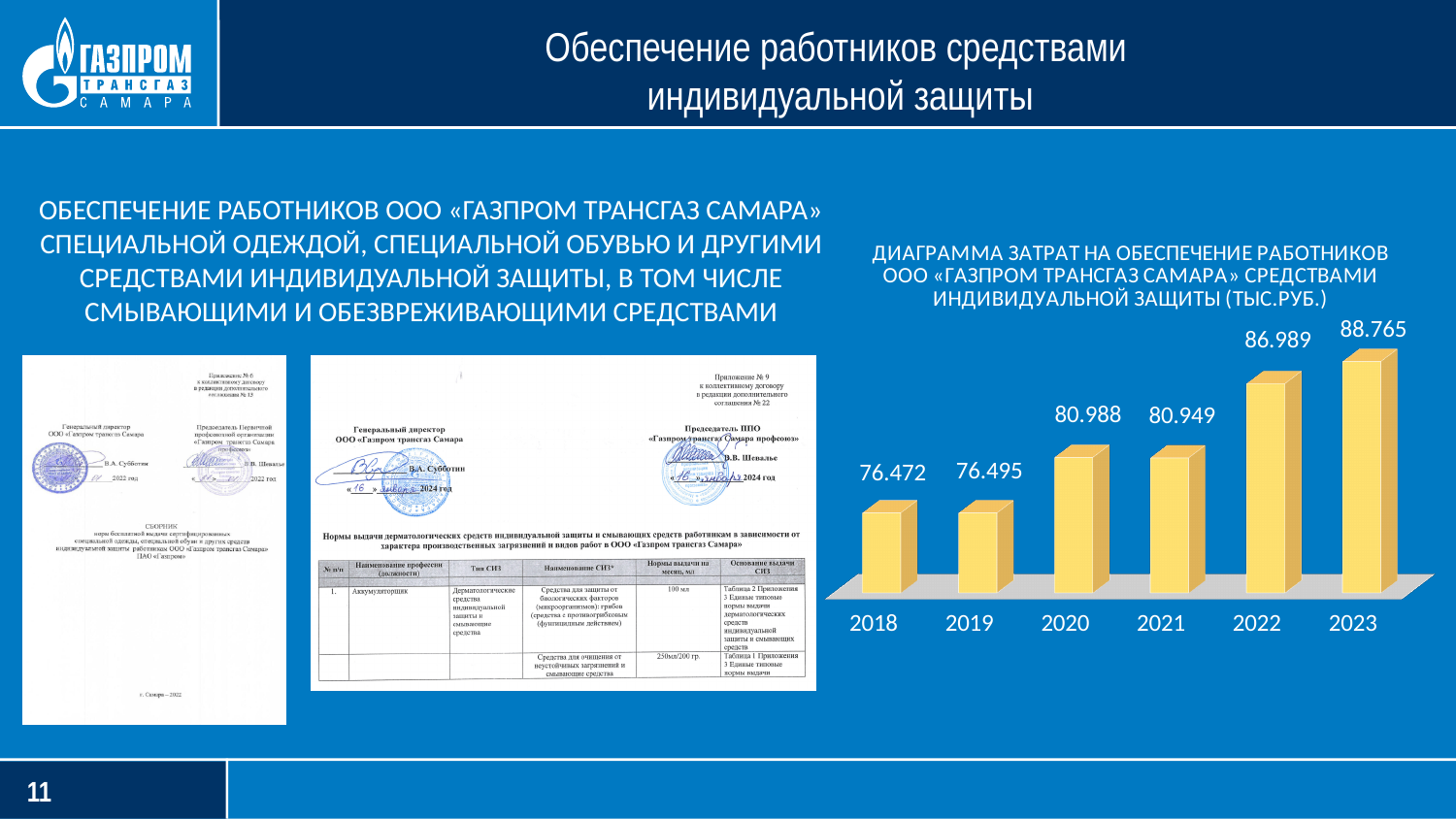
What is the value for 2021 in the chart? 80.949 What kind of chart is shown on the slide? bar chart What is the value for 2023 in the chart? 88.765 How many years are shown in the chart? 6 Which year has the highest value in the chart? 2023 What is the value for 2020 in the chart? 80.988 Which year has the lowest value in the chart? 2018 What is the difference between the values for 2023 and 2022? 1.776 What is the difference between the values for 2023 and 2018? 12.293 Which is larger, the value for 2022 or the value for 2020? 2022 What is the value for 2018 in the chart? 76.472 Do the values generally rise or fall from 2018 to 2023? rise